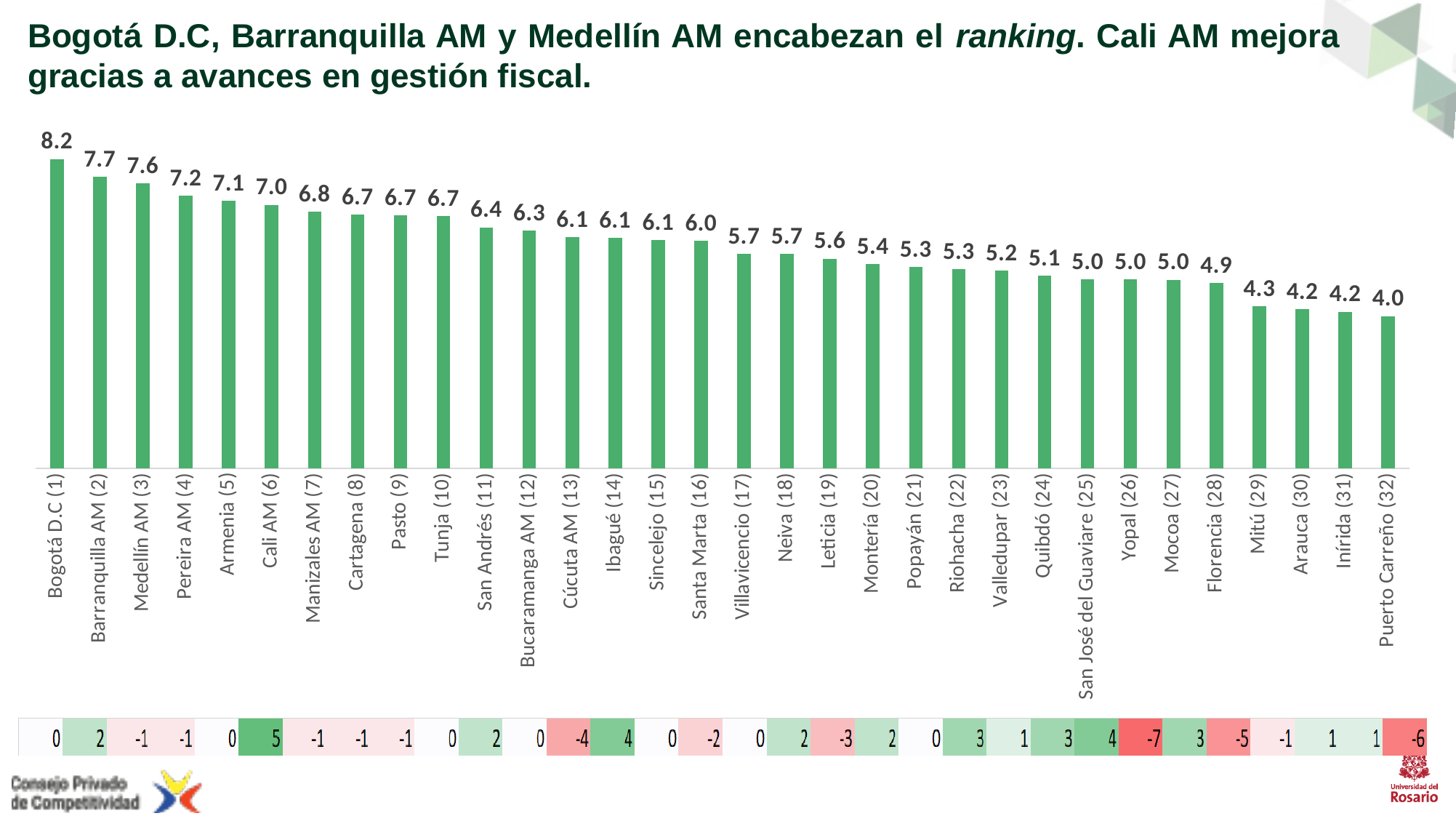
Which city has the lowest value in the chart? Puerto Carreño What kind of chart is shown on the slide? bar chart Which city has the highest value in the chart? Bogotá D.C What is the difference between the values for Cali AM and Mitú? 2.7 Which has a larger value, Medellín AM or Pereira AM? Medellín AM How many cities or metropolitan areas are plotted in the chart? 32 What is the value for Bucaramanga AM? 6.3 What is the value for Cali AM? 7.0 What is the value for Bogotá D.C? 8.2 What is the difference between the values for Bogotá D.C and Barranquilla AM? 0.5 What is the value for Puerto Carreño? 4.0 Do the values rise or fall moving from left to right along the x axis? fall